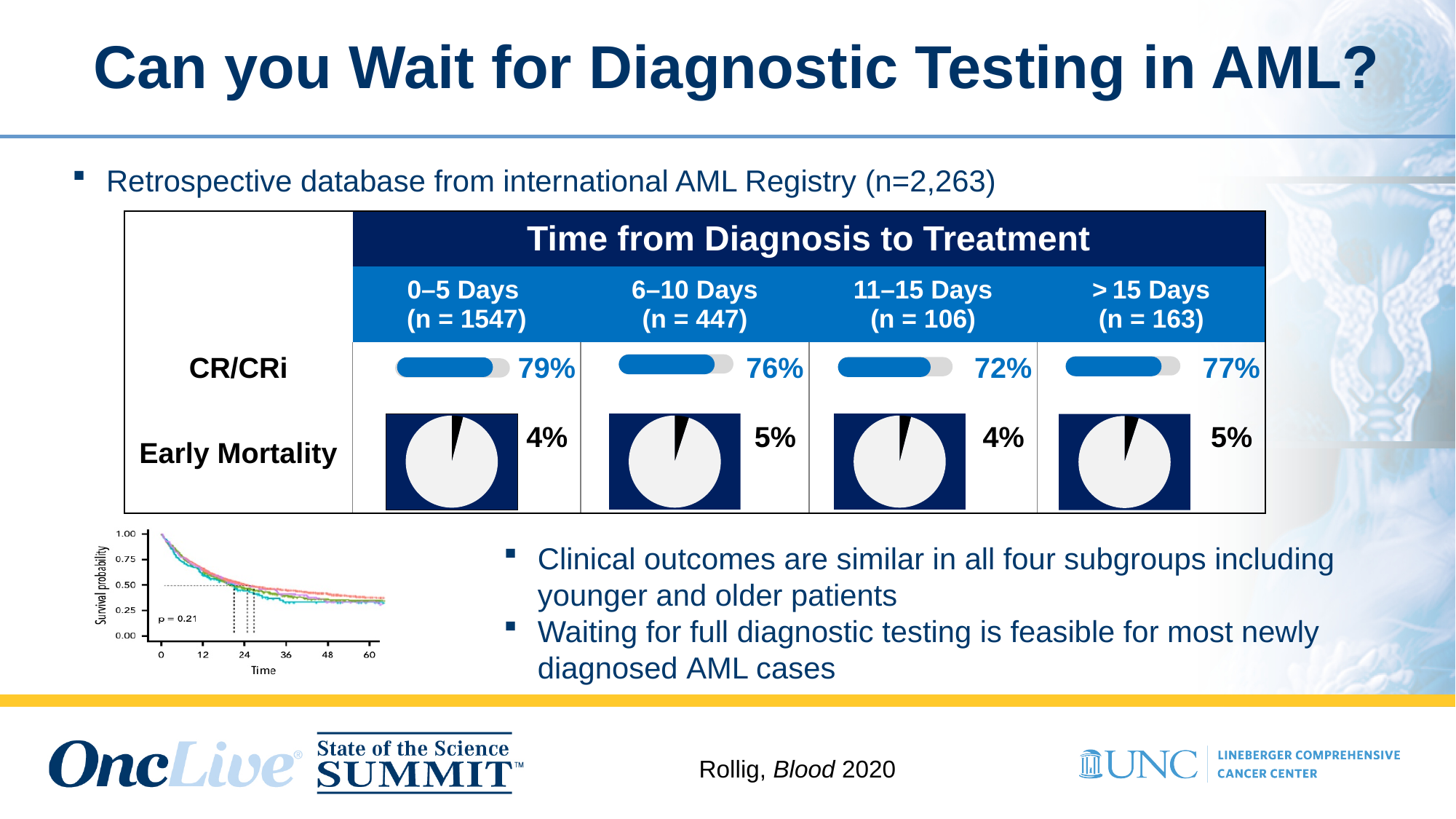
In the Time from Diagnosis to Treatment table, which has the higher CR/CRi rate: the 6–10 Days group or the > 15 Days group? > 15 Days What p-value is printed on the survival curve chart at the bottom left of the slide? p = 0.21 What is the y-axis label of the survival curve chart at the bottom left of the slide? Survival probability What kind of chart is used to show Early Mortality in the table? Pie chart In the Time from Diagnosis to Treatment table, what is the CR/CRi rate for the 0–5 Days group? 79% In the Time from Diagnosis to Treatment table, what is the difference in CR/CRi rate between the 0–5 Days group and the 11–15 Days group? 7 percentage points In the Time from Diagnosis to Treatment table, which group has the lowest CR/CRi rate? 11–15 Days In the Time from Diagnosis to Treatment table, what is the CR/CRi rate for the 11–15 Days group? 72% In the Time from Diagnosis to Treatment table, what is the difference in Early Mortality between the > 15 Days group and the 0–5 Days group? 1 percentage point In the Time from Diagnosis to Treatment table, which group has the highest CR/CRi rate? 0–5 Days In the Time from Diagnosis to Treatment table, what is the Early Mortality rate for the 6–10 Days group? 5% How many Time from Diagnosis to Treatment groups are shown in the table? 4